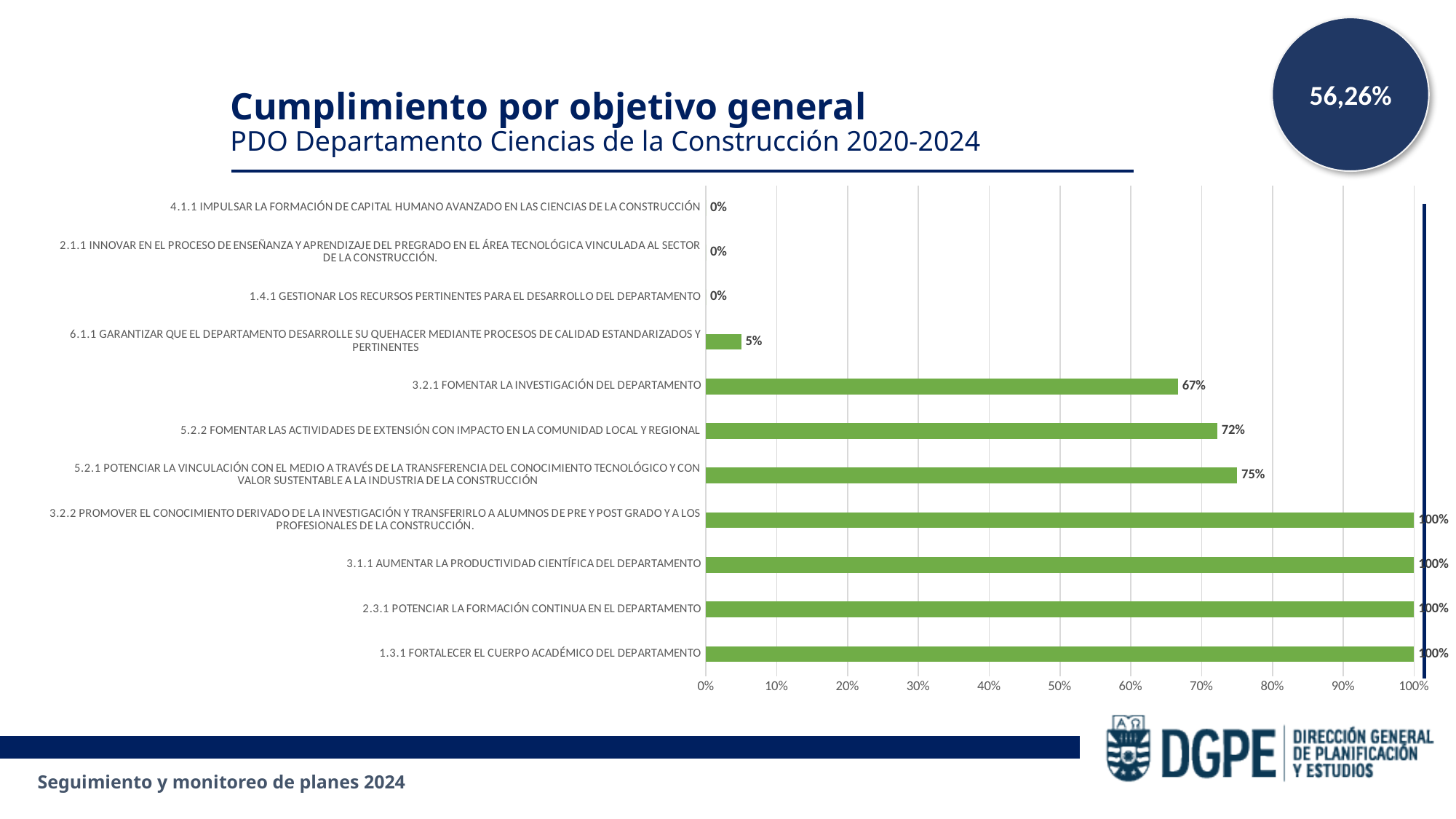
What kind of chart is shown on the slide? Bar chart What is the value for 5.2.2 FOMENTAR LAS ACTIVIDADES DE EXTENSIÓN CON IMPACTO EN LA COMUNIDAD LOCAL Y REGIONAL? 72% What is the title of the chart on the slide? Cumplimiento por objetivo general What is the value for 3.2.1 FOMENTAR LA INVESTIGACIÓN DEL DEPARTAMENTO? 67% How many categories have a value of 100%? 4 What is the difference between the values for 5.2.1 POTENCIAR LA VINCULACIÓN CON EL MEDIO and 3.2.1 FOMENTAR LA INVESTIGACIÓN DEL DEPARTAMENTO? 8% Which is larger, the value for 5.2.2 FOMENTAR LAS ACTIVIDADES DE EXTENSIÓN or the value for 3.2.1 FOMENTAR LA INVESTIGACIÓN DEL DEPARTAMENTO? 5.2.2 FOMENTAR LAS ACTIVIDADES DE EXTENSIÓN What is the value for 5.2.1 POTENCIAR LA VINCULACIÓN CON EL MEDIO A TRAVÉS DE LA TRANSFERENCIA DEL CONOCIMIENTO TECNOLÓGICO Y CON VALOR SUSTENTABLE A LA INDUSTRIA DE LA CONSTRUCCIÓN? 75% What is the value for 6.1.1 GARANTIZAR QUE EL DEPARTAMENTO DESARROLLE SU QUEHACER MEDIANTE PROCESOS DE CALIDAD ESTANDARIZADOS Y PERTINENTES? 5% How many categories are shown in the chart? 11 What is the value for 1.4.1 GESTIONAR LOS RECURSOS PERTINENTES PARA EL DESARROLLO DEL DEPARTAMENTO? 0% Is the value for 3.2.1 FOMENTAR LA INVESTIGACIÓN DEL DEPARTAMENTO greater or less than 60%? greater